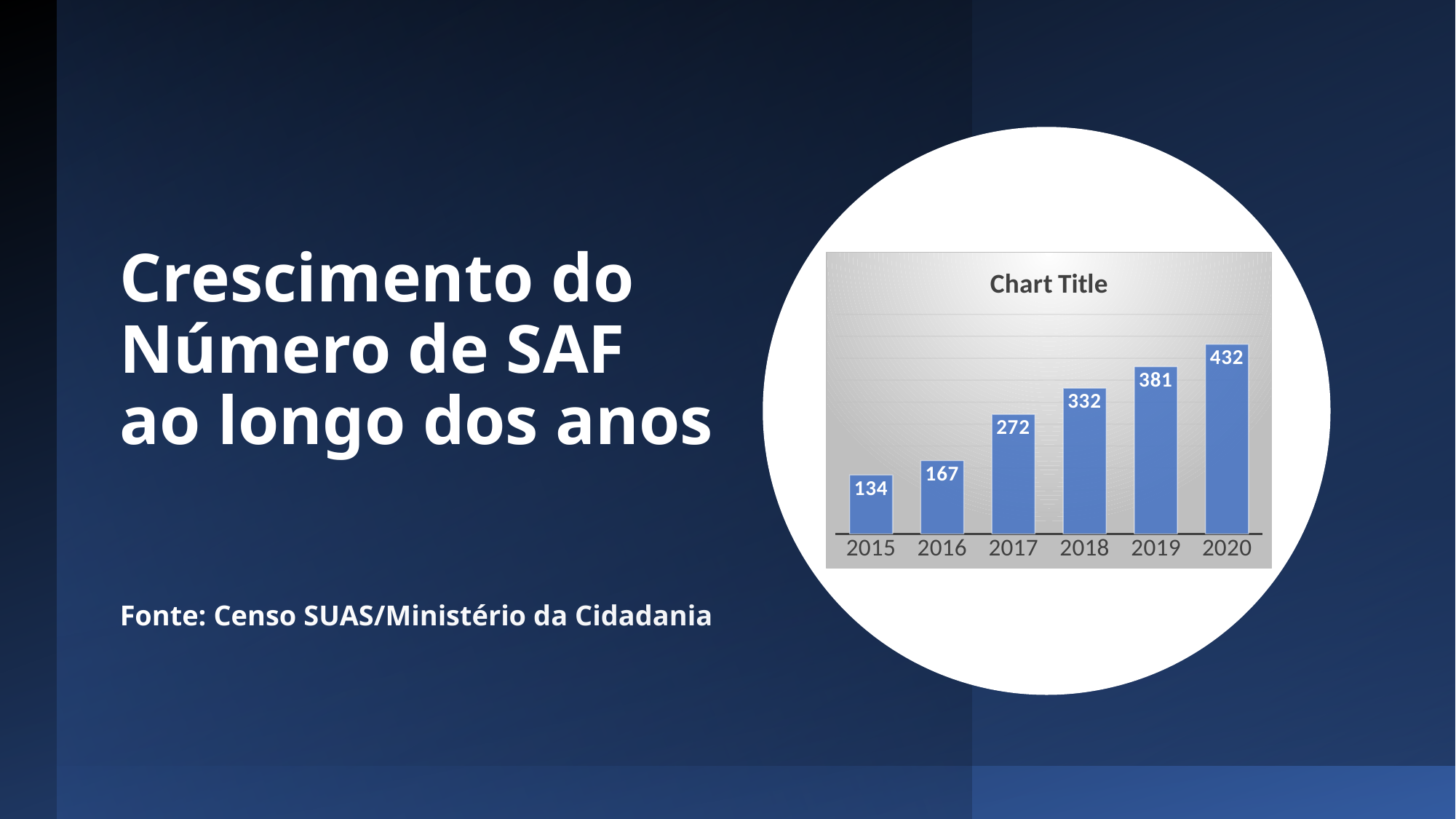
Do the values rise or fall from 2015 to 2020? rise What is the difference between the values for 2020 and 2015? 298 What is the value for 2015? 134 Which year has the highest value? 2020 What is the value for 2020? 432 What is the title shown on the chart? Chart Title Which is larger, the value for 2019 or the value for 2017? 2019 What is the value for 2018? 332 What kind of chart is shown? bar chart What is the difference between the values for 2017 and 2016? 105 How many years are shown on the x axis? 6 Which year has the lowest value? 2015